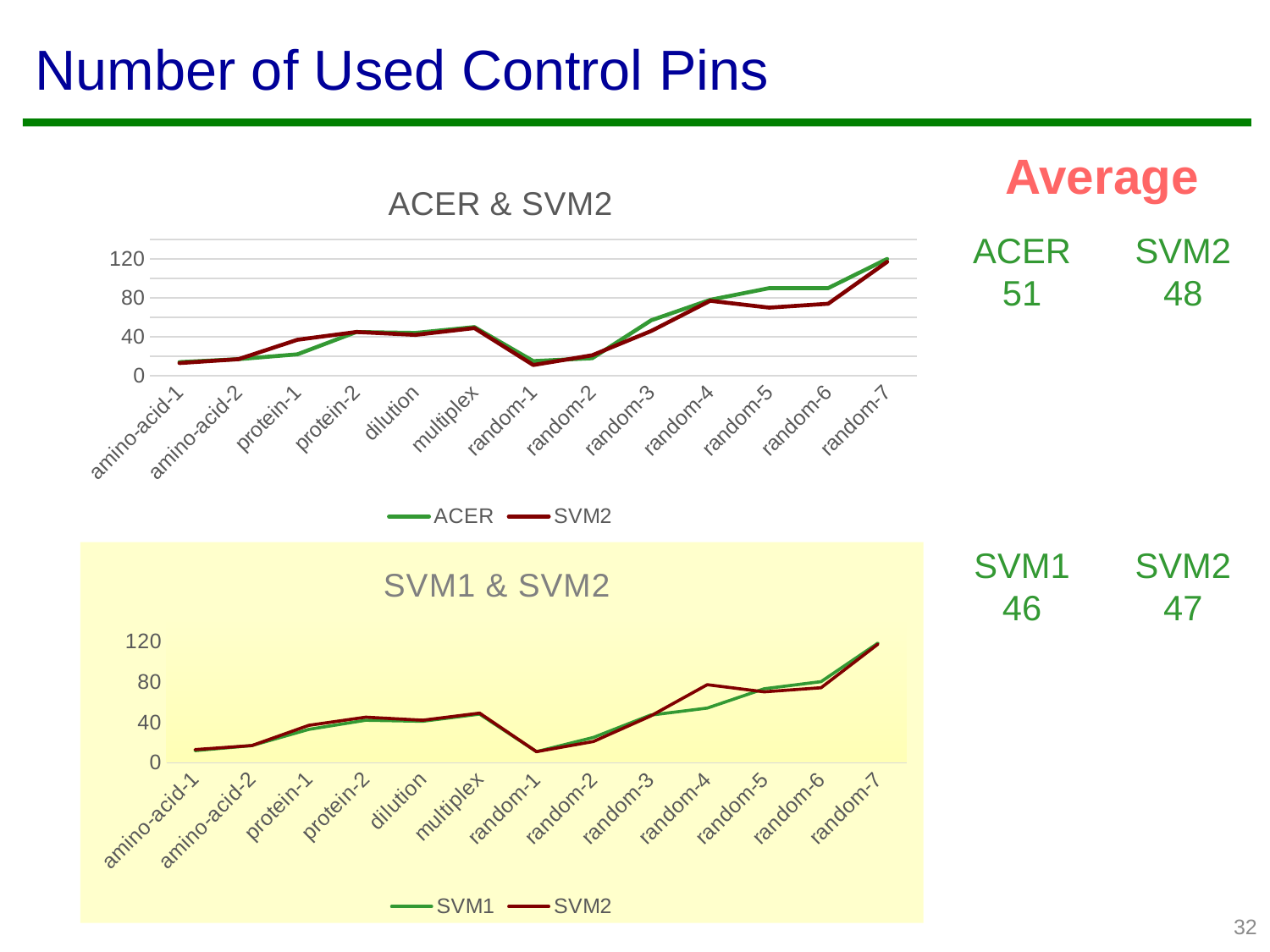
How many series does the legend of the "SVM1 & SVM2" chart list? 2 In the "ACER & SVM2" chart, which series has the larger value at random-5, ACER or SVM2? ACER In the "ACER & SVM2" chart, is the SVM2 value for random-1 greater or less than 40? less In the "ACER & SVM2" chart, is the ACER value for random-7 greater or less than 80? greater In the "SVM1 & SVM2" chart, is the SVM1 value for amino-acid-1 greater or less than 40? less In the "ACER & SVM2" chart, which category has the highest value for the ACER series? random-7 In the "SVM1 & SVM2" chart, do the values rise or fall from random-1 to random-7? rise What kind of chart is the "ACER & SVM2" chart? line chart How many categories are shown on the x axis of the "ACER & SVM2" chart? 13 In the "SVM1 & SVM2" chart, which category has the highest value for the SVM2 series? random-7 In the "SVM1 & SVM2" chart, which series has the larger value at random-4, SVM1 or SVM2? SVM2